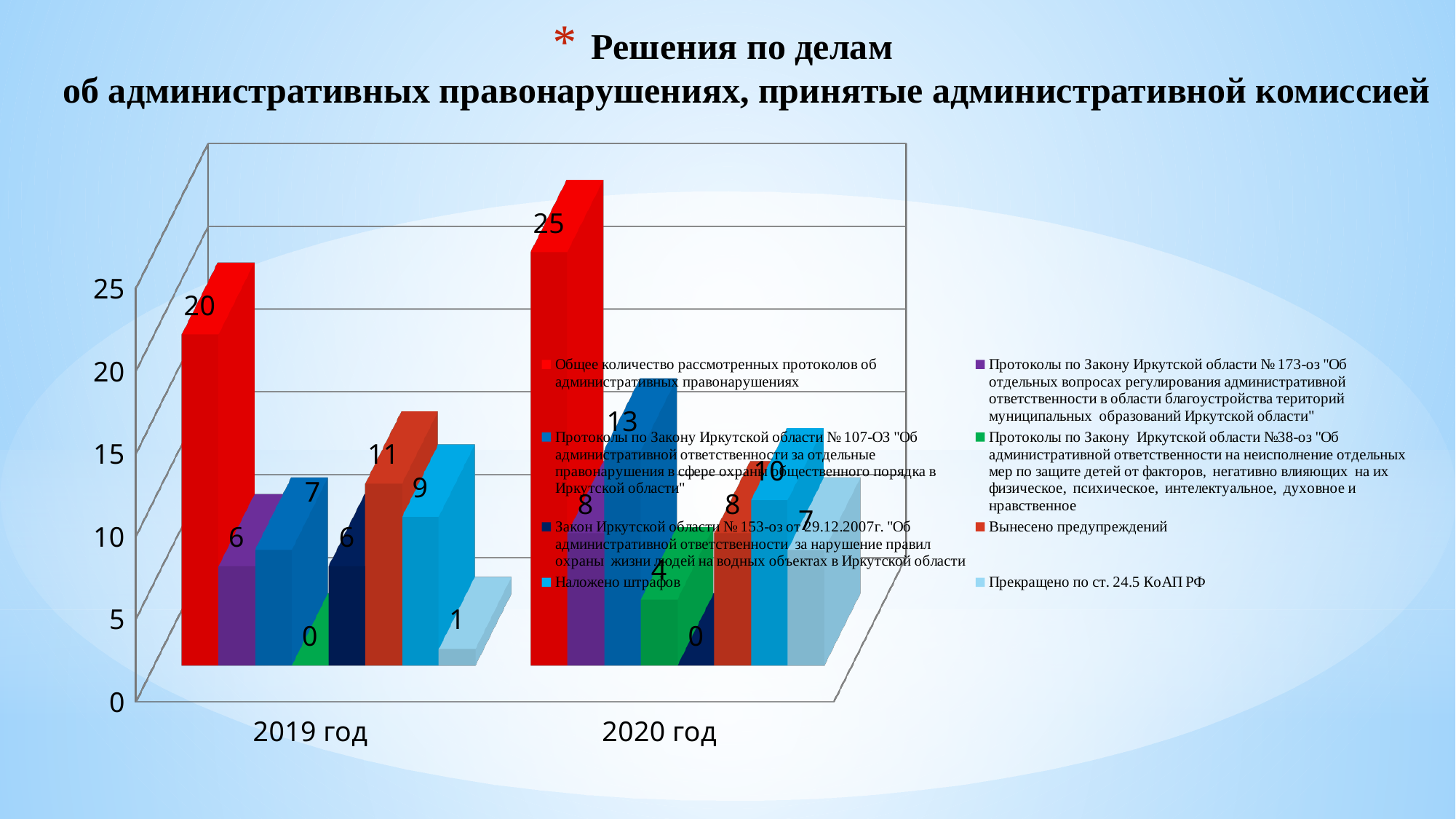
How many cases were terminated under ст. 24.5 КоАП РФ (Прекращено) in 2019 год? 1 How many year categories are shown on the x axis? 2 What kind of chart is shown on the slide? Bar chart What is the total number of reviewed protocols (Общее количество рассмотренных протоколов) in 2020 год? 25 How many series does the legend list? 8 Which series has the highest value in 2020 год? Общее количество рассмотренных протоколов об административных правонарушениях By how much did the total number of reviewed protocols increase from 2019 год to 2020 год? 5 Which year had more warnings issued (Вынесено предупреждений), 2019 год or 2020 год? 2019 год How many warnings (Вынесено предупреждений) were issued in 2019 год? 11 What is the value for protocols under Закон № 38-оз in 2019 год? 0 What is the total number of reviewed protocols (Общее количество рассмотренных протоколов) in 2019 год? 20 How many fines (Наложено штрафов) were imposed in 2020 год? 10